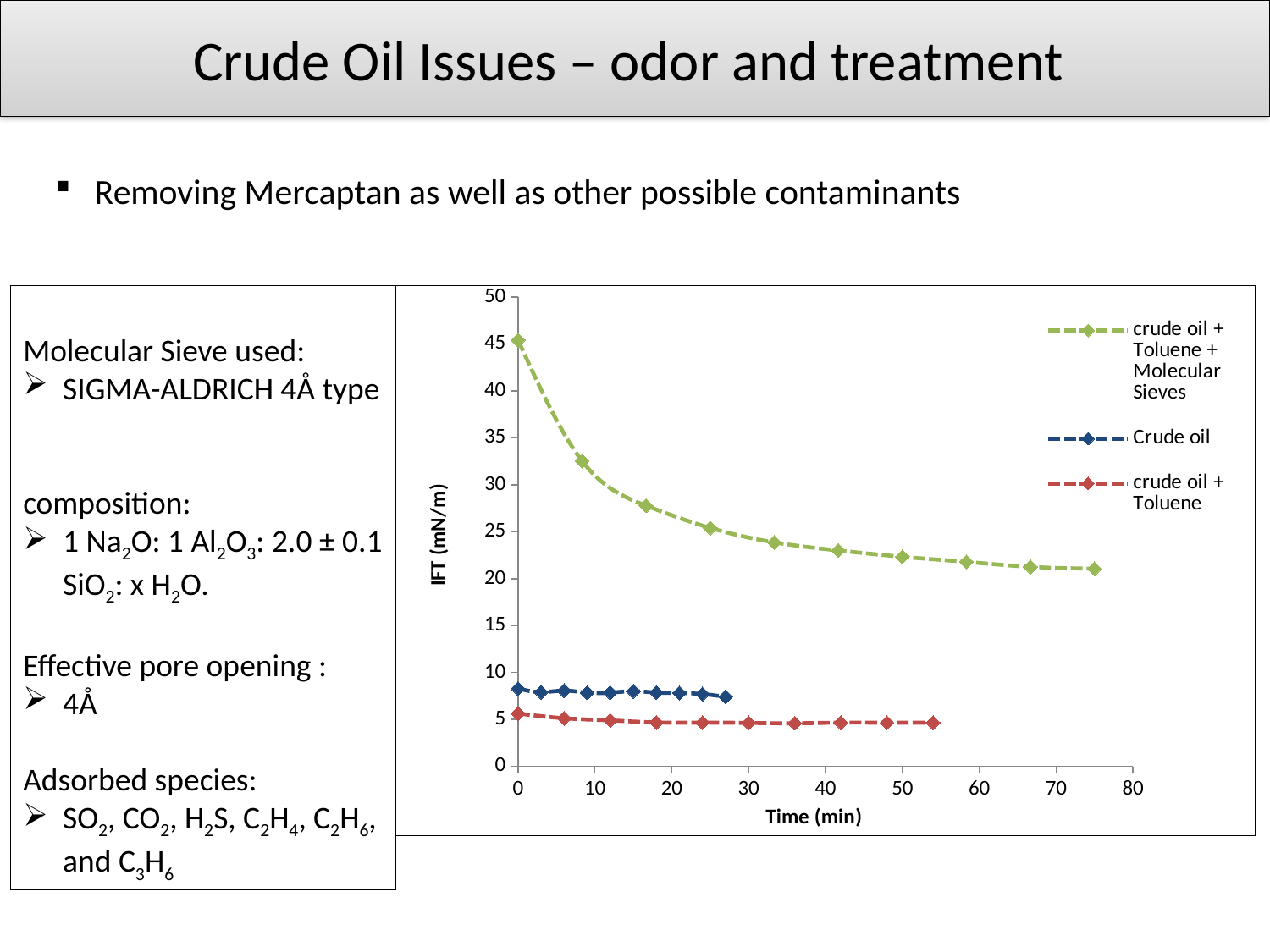
Is the IFT value for the Crude oil series at time 0 greater or less than 10 mN/m? less Is the IFT value for crude oil + Toluene + Molecular Sieves at time 0 greater or less than 40 mN/m? greater What is the label of the horizontal axis of the chart? Time (min) What is the label of the vertical axis of the chart? IFT (mN/m) Is the IFT value for crude oil + Toluene at time 0 greater or less than 10 mN/m? less Which series has the lowest IFT values throughout the chart? crude oil + Toluene What kind of chart is shown on the slide? line chart How many series does the chart legend list? 3 Which series has the highest IFT values throughout the chart? crude oil + Toluene + Molecular Sieves Does the IFT for the crude oil + Toluene + Molecular Sieves series rise or fall as time increases? fall At time 0, which series has the larger IFT value: Crude oil or crude oil + Toluene? Crude oil